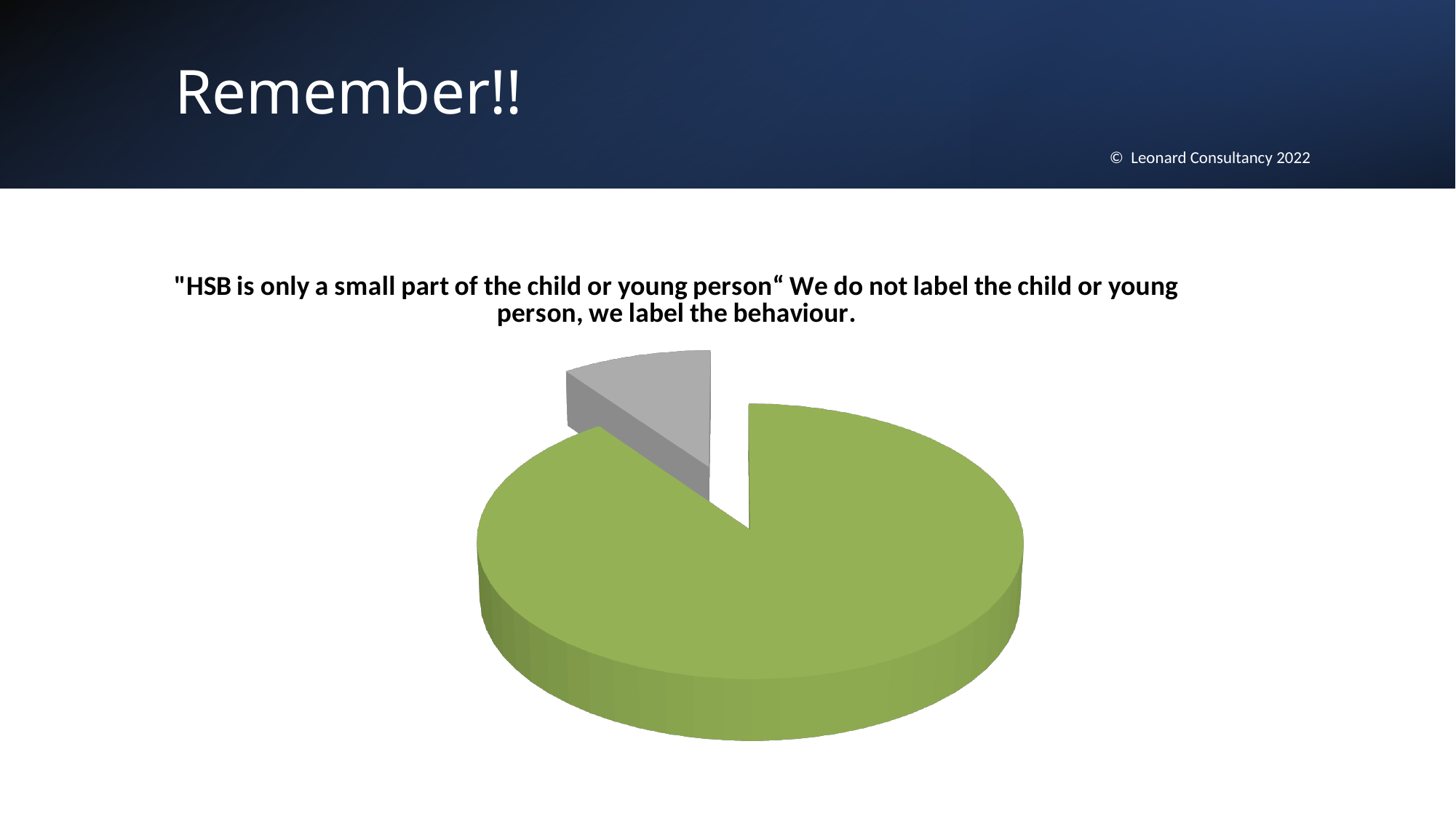
Which slice of the pie chart is larger, the green slice or the grey slice? The green slice How many slices does the pie chart have? 2 Which slice takes up the smallest share of the pie chart? The grey slice What colour is the small slice that is pulled out from the pie chart? Grey What kind of chart is shown on the slide? Pie chart What is the title shown above the pie chart? "HSB is only a small part of the child or young person" We do not label the child or young person, we label the behaviour. Which slice takes up the largest share of the pie chart? The green slice